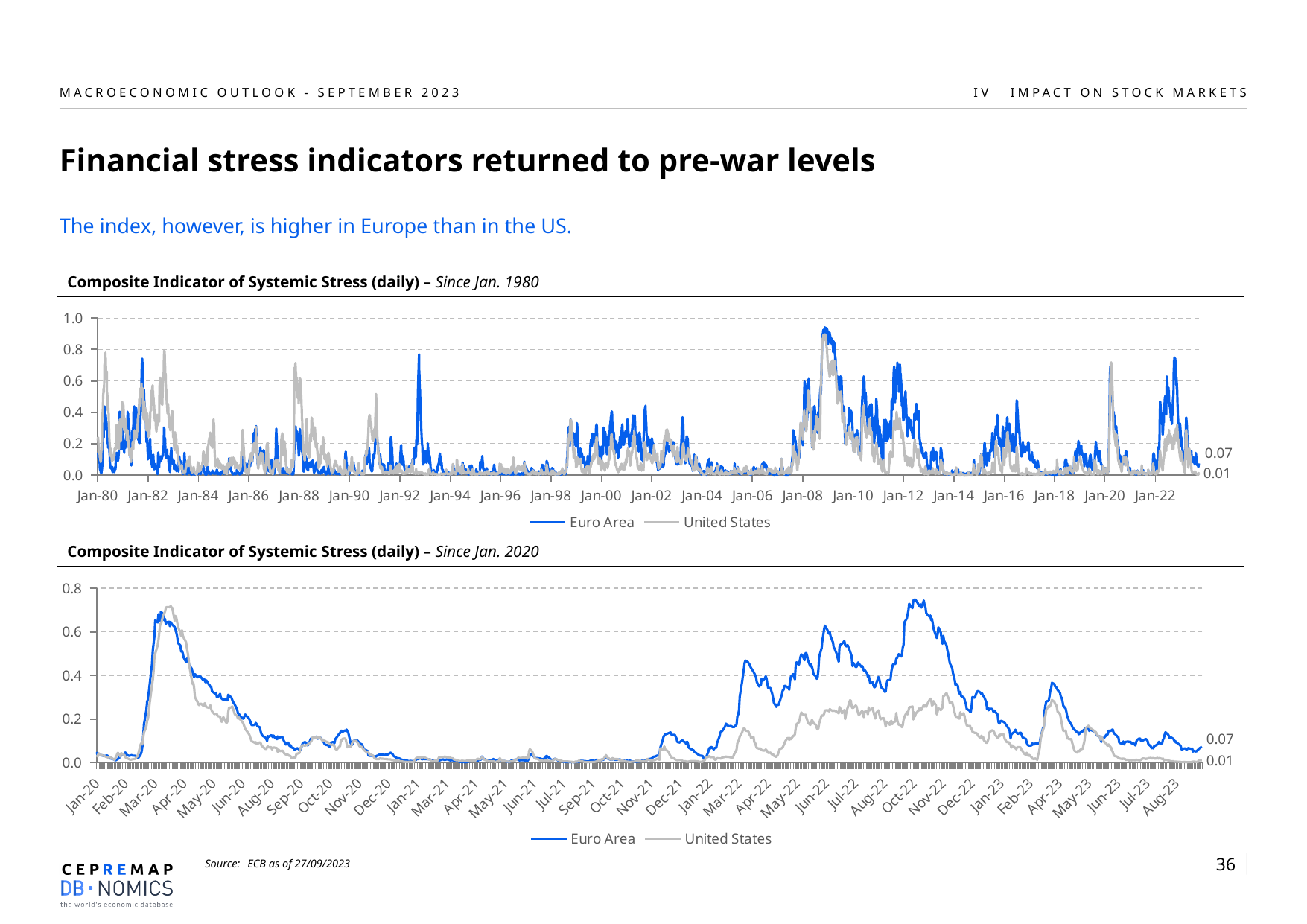
On the 'Since Jan. 2020' chart, which series has the higher latest labelled value, Euro Area or United States? Euro Area What is the title of the top chart on the slide? Composite Indicator of Systemic Stress (daily) – Since Jan. 1980 On the 'Since Jan. 2020' chart, which series is higher around Jun-22, Euro Area or United States? Euro Area On the 'Since Jan. 1980' chart, is the Euro Area peak around Jan-08 to Jan-10 greater or less than 0.8? greater On the 'Since Jan. 1980' chart, what is the latest labelled value for the Euro Area? 0.07 On the 'Since Jan. 1980' chart, what is the difference between the latest labelled Euro Area value and the latest labelled United States value? 0.06 How many series does the legend of the 'Since Jan. 2020' chart list? 2 On the 'Since Jan. 2020' chart, is the United States value around Nov-22 greater or less than 0.4? less What kind of chart is the 'Composite Indicator of Systemic Stress (daily) – Since Jan. 1980' chart? Line chart On the 'Since Jan. 2020' chart, what is the latest labelled value for the United States? 0.01 In the legend of the charts, which colour represents the Euro Area? Blue On the 'Since Jan. 2020' chart, is the Euro Area peak around Oct-22 greater or less than 0.6? greater